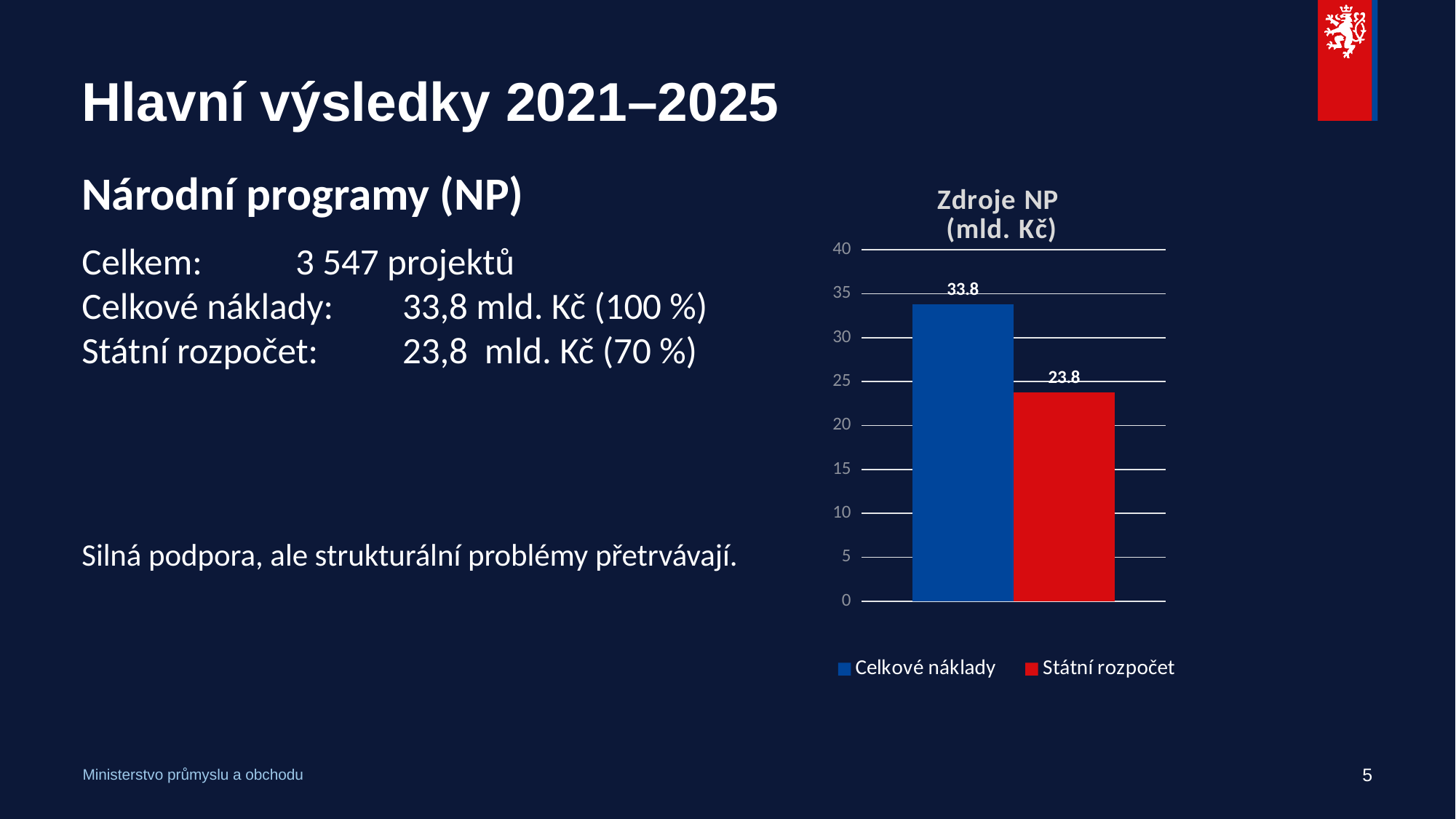
Which series has the lower value in the Zdroje NP chart? Státní rozpočet Is the value for Státní rozpočet greater or less than 25? less Is the value for Celkové náklady greater or less than 30? greater What type of chart is shown on the slide? bar chart Is the Celkové náklady bar larger or smaller than the Státní rozpočet bar? larger What is the value of the Celkové náklady bar in the Zdroje NP chart? 33.8 What is the difference between the Celkové náklady and Státní rozpočet values in the Zdroje NP chart? 10 What is the value of the Státní rozpočet bar in the Zdroje NP chart? 23.8 What is the title of the chart on the slide? Zdroje NP (mld. Kč) Which series has the higher value in the Zdroje NP chart? Celkové náklady How many series does the legend of the Zdroje NP chart list? 2 How many bars are plotted in the Zdroje NP chart? 2